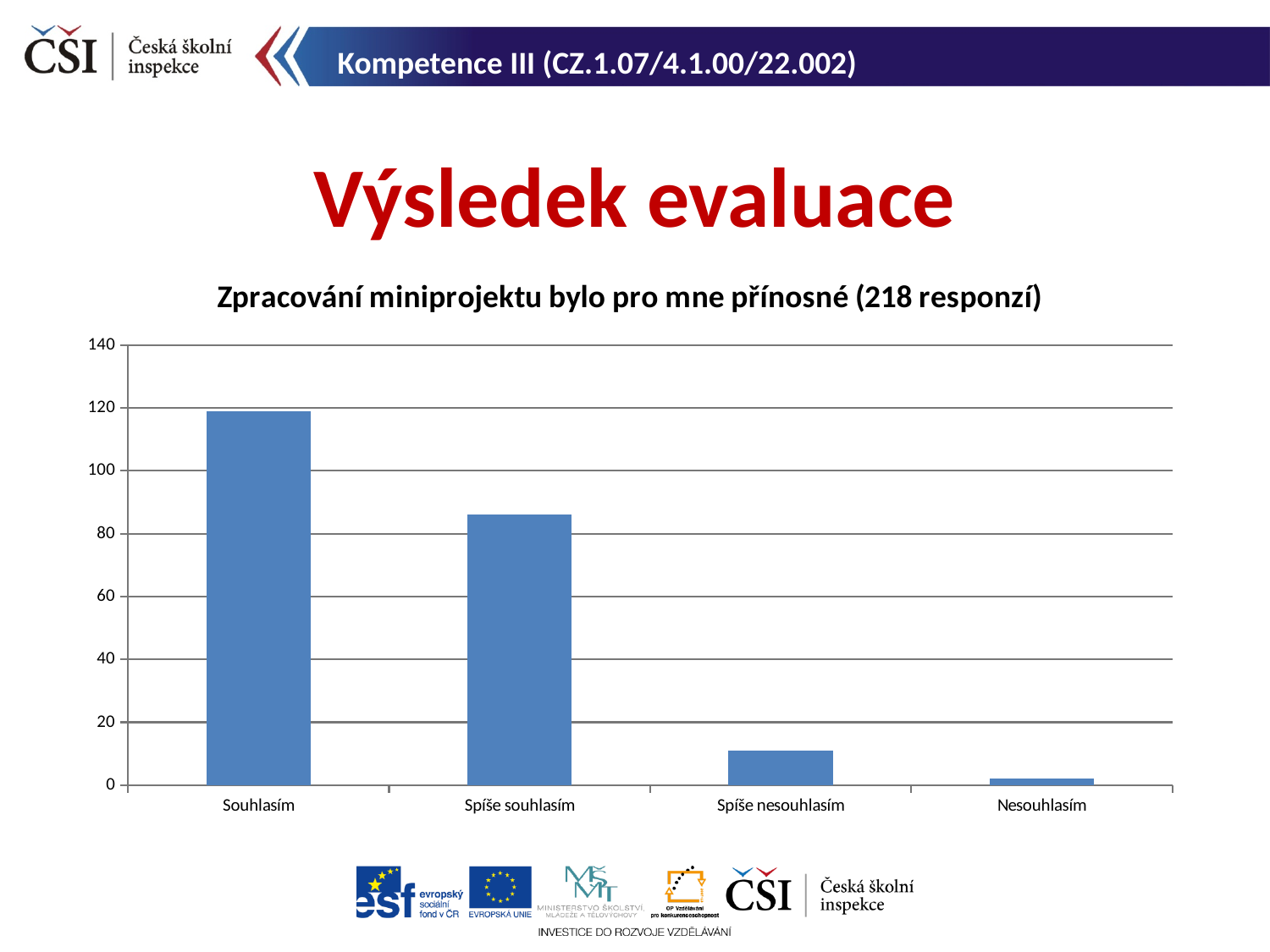
Is the value for Souhlasím greater or less than 100? greater Is the value for Spíše souhlasím greater or less than 80? greater Is the value for Spíše souhlasím greater or less than 100? less How many categories are shown on the x axis of the chart? 4 What kind of chart is shown on the slide? bar chart What is the title of the chart? Zpracování miniprojektu bylo pro mne přínosné (218 responzí) How many responses does the chart title say were collected? 218 Which is larger, the value for Spíše souhlasím or the value for Spíše nesouhlasím? Spíše souhlasím Which category has the highest bar? Souhlasím Do the bar values rise or fall from left to right along the x axis? fall Which category has the lowest bar? Nesouhlasím